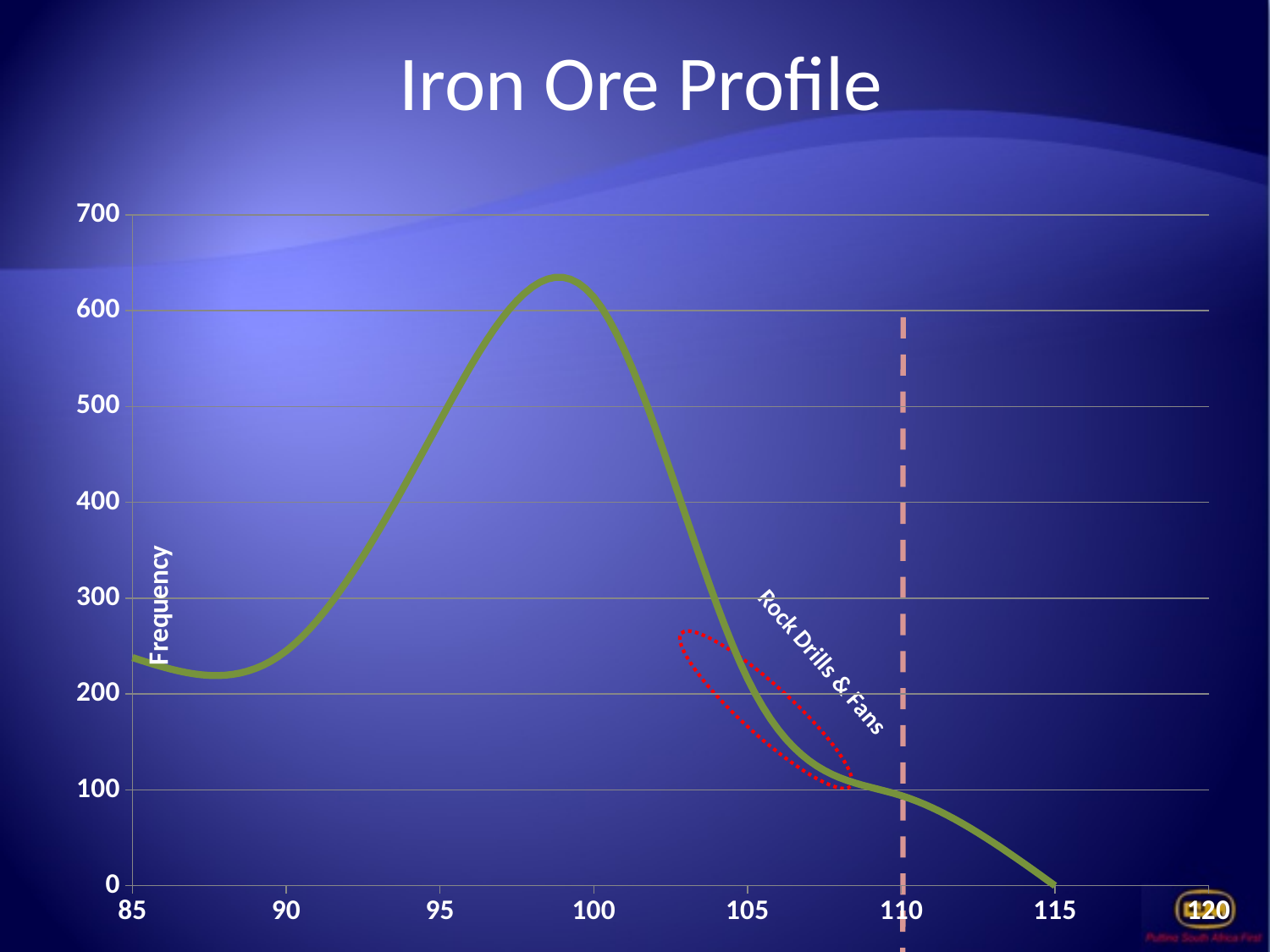
What kind of chart is shown on the slide? line chart What is the label on the vertical axis of the chart? Frequency Is the value of the curve at 100 greater or less than 500? greater Is the value of the curve at 105 greater or less than 300? less Is the peak value of the curve greater or less than 600? greater What is the title of the chart? Iron Ore Profile Do the values of the curve rise or fall between 100 and 110 on the x axis? fall Do the values of the curve rise or fall between 90 and 98 on the x axis? rise Which is larger, the value of the curve at 100 or at 110? 100